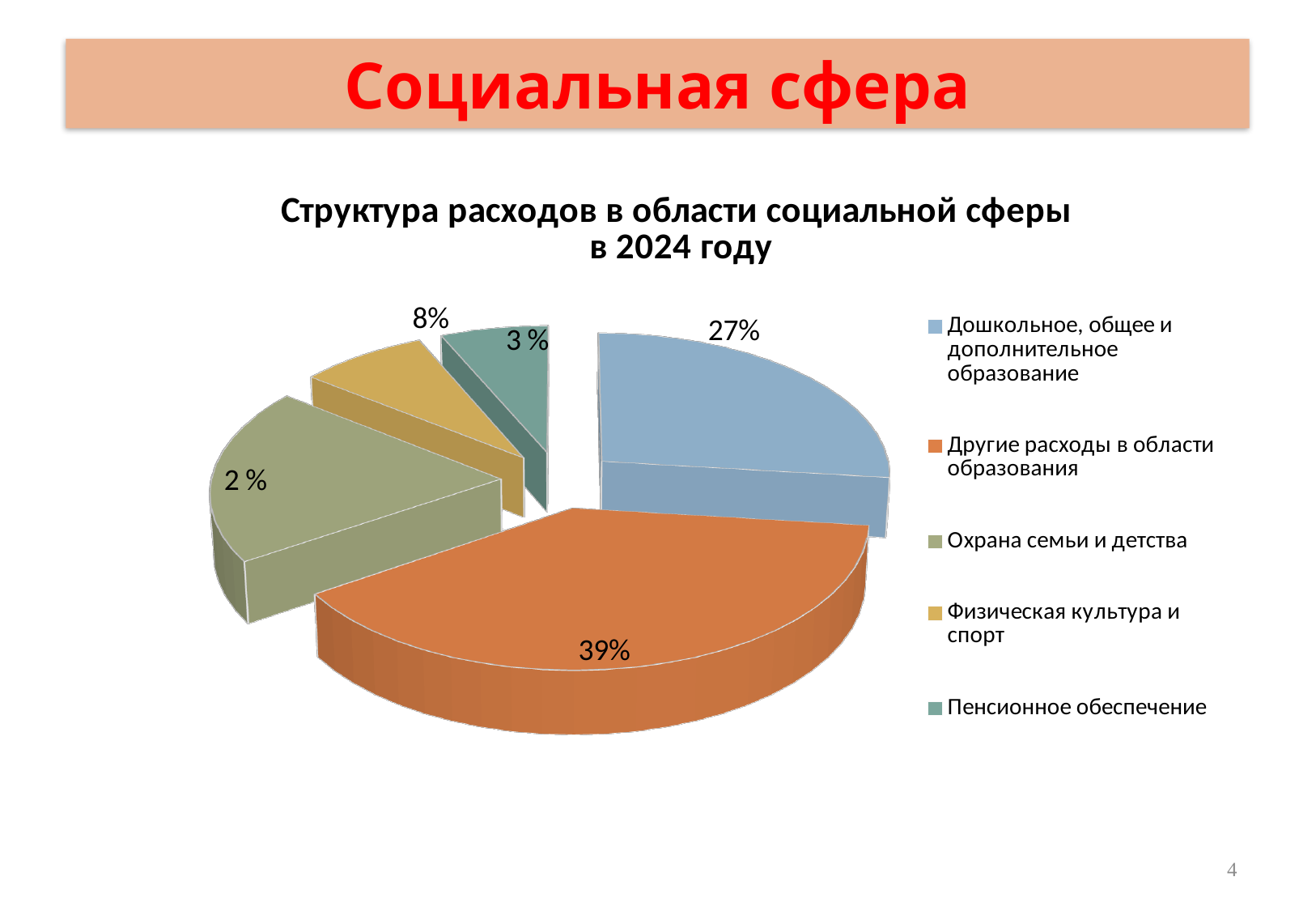
What is the difference in percentage points between "Физическая культура и спорт" and "Пенсионное обеспечение"? 5 percentage points What share is shown for "Физическая культура и спорт"? 8% Which category has the largest slice of the pie? Другие расходы в области образования What is the title of the chart? Структура расходов в области социальной сферы в 2024 году Which is larger: the slice for "Дошкольное, общее и дополнительное образование" or the slice for "Физическая культура и спорт"? Дошкольное, общее и дополнительное образование How many categories does the pie chart contain? 5 What colour is the slice for "Другие расходы в области образования"? Orange What share is shown for "Дошкольное, общее и дополнительное образование"? 27% What share of expenditure is labelled for "Другие расходы в области образования"? 39% What is the difference in percentage points between "Другие расходы в области образования" and "Дошкольное, общее и дополнительное образование"? 12 percentage points What share is shown for "Пенсионное обеспечение"? 3 % What kind of chart is shown on the slide? Pie chart